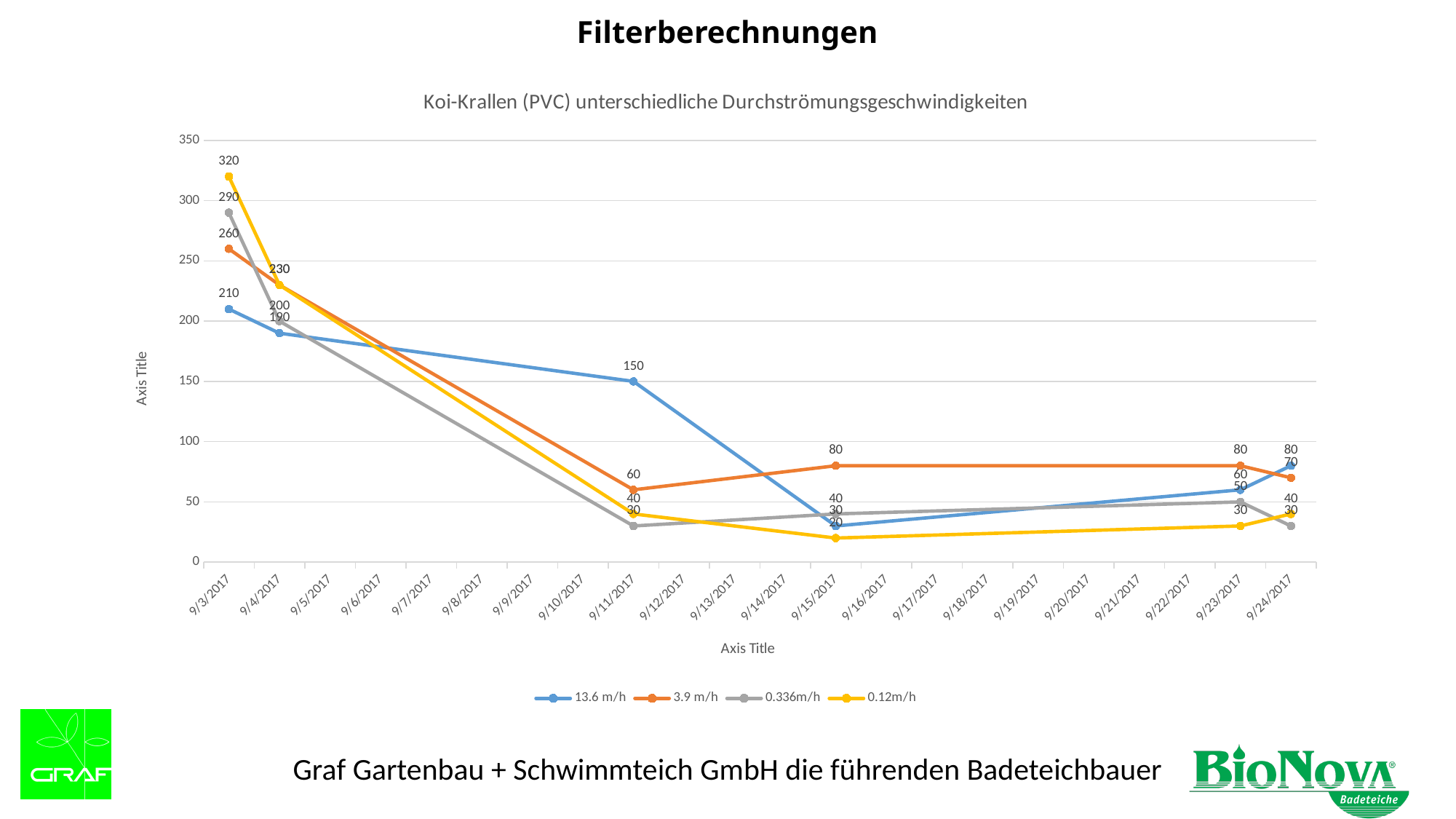
What is the value of the 3.9 m/h series on 9/3/2017? 260 What is the value of the 13.6 m/h series on 9/11/2017? 150 What is the value of the 0.12m/h series on 9/3/2017? 320 Does the 13.6 m/h series rise or fall from 9/3/2017 to 9/15/2017? fall What is the difference between the 0.12m/h and 13.6 m/h values on 9/3/2017? 110 How many series does the legend list? 4 Which series has the lowest value on 9/3/2017? 13.6 m/h What is the title of the chart? Koi-Krallen (PVC) unterschiedliche Durchströmungsgeschwindigkeiten What kind of chart is shown on the slide? line chart On 9/11/2017, which is larger: the 13.6 m/h value or the 3.9 m/h value? 13.6 m/h What is the value of the 0.336m/h series on 9/3/2017? 290 Which series has the highest value on 9/3/2017? 0.12m/h